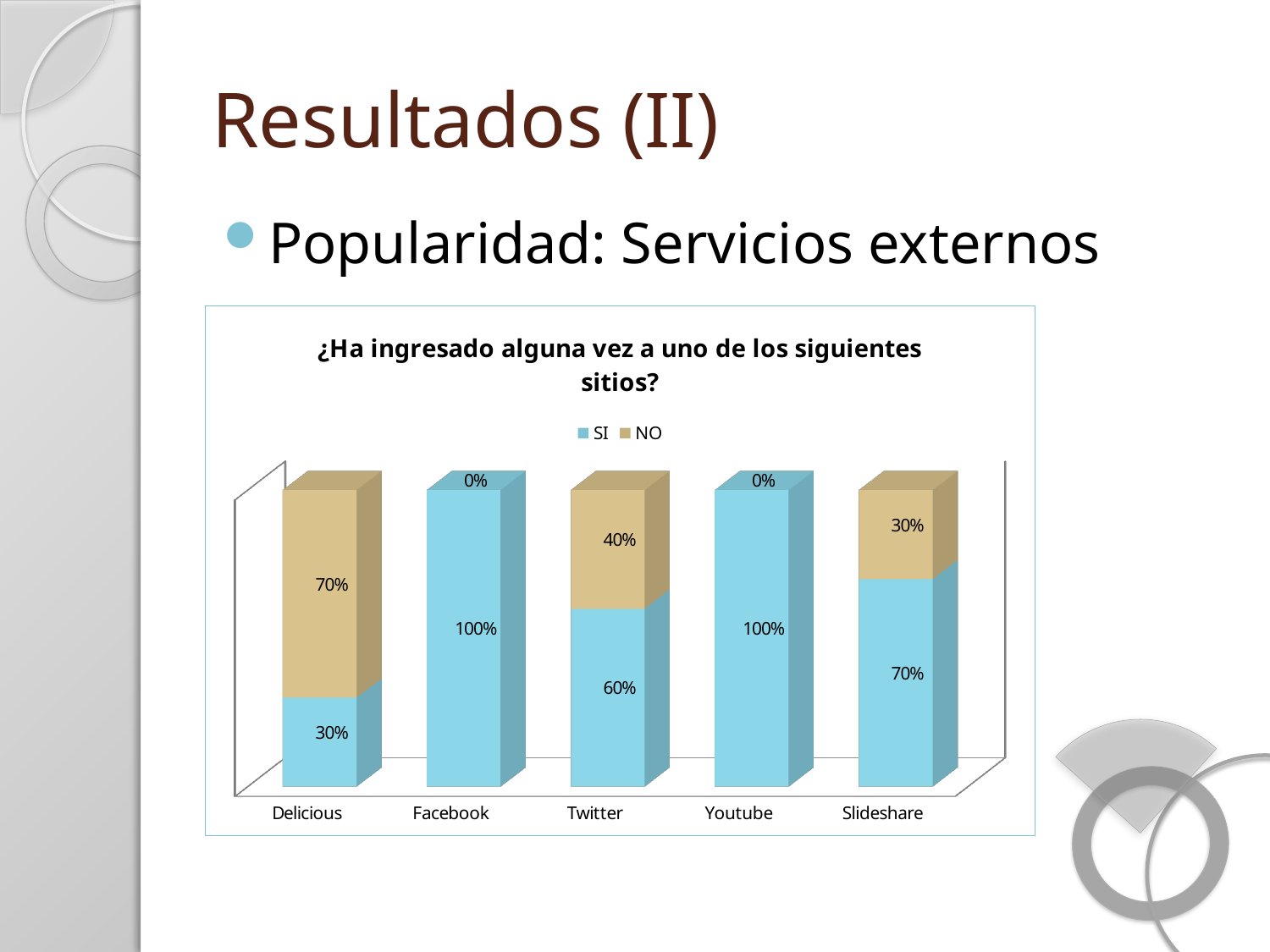
Which site has the lowest SI value? Delicious How many sites are shown on the x axis? 5 Which is larger, the NO value for Twitter or the NO value for Slideshare? Twitter What is the SI value for Slideshare? 70% What is the NO value for Twitter? 40% What is the total of the stacked bar for Youtube? 100% What is the difference between the SI values for Twitter and Delicious? 30% What is the SI value for Delicious? 30% How many series does the legend list? 2 Which site has the highest NO value? Delicious What is the NO value for Facebook? 0% What kind of chart is shown? Stacked bar chart